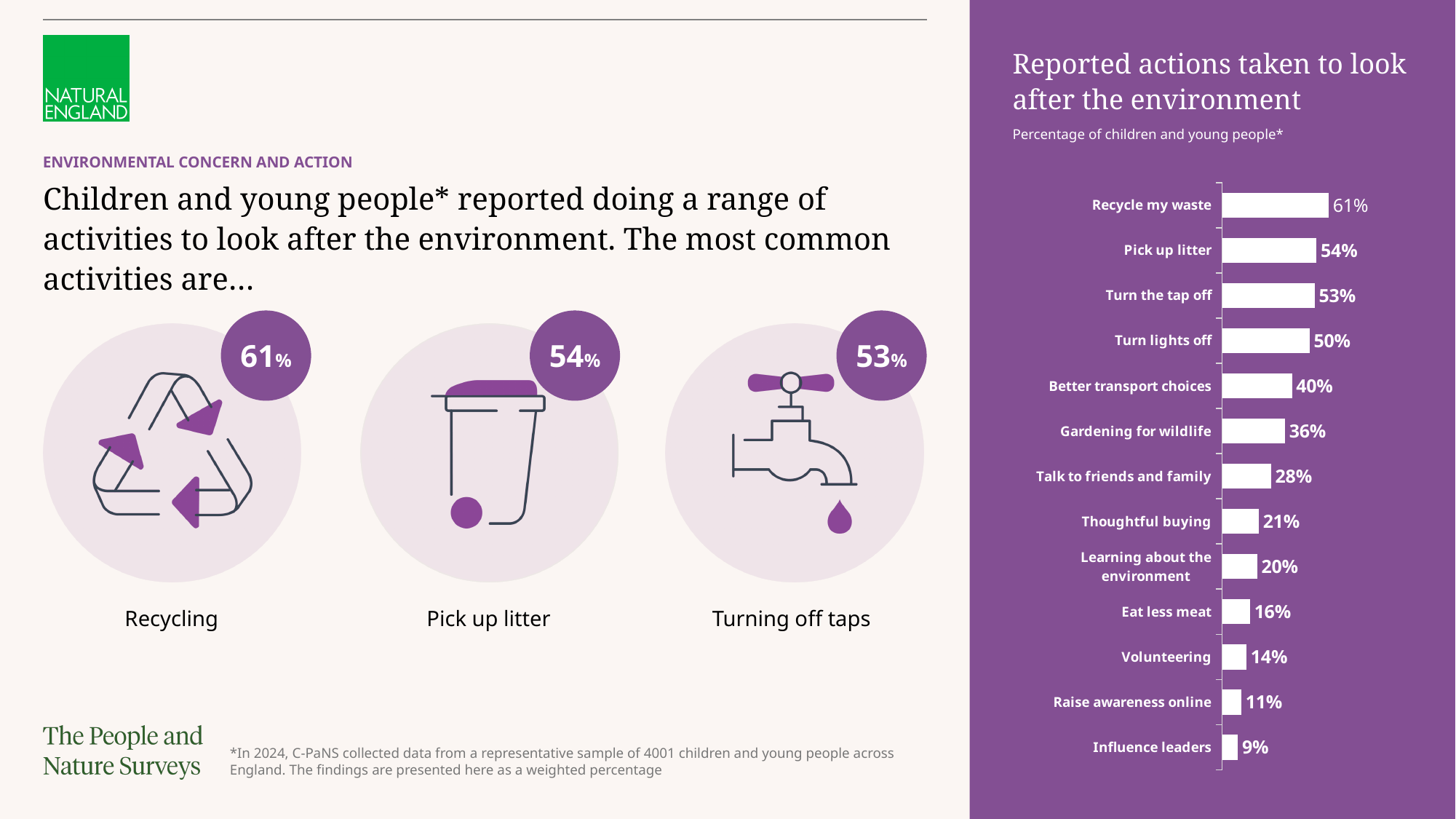
What is the value for 'Gardening for wildlife' in the bar chart? 36% What is the difference in percentage points between 'Better transport choices' and 'Eat less meat'? 24 How many reported actions are listed in the bar chart? 13 Which is larger: the value for 'Talk to friends and family' or the value for 'Thoughtful buying'? Talk to friends and family What is the title of the chart on the right side of the slide? Reported actions taken to look after the environment What is the difference in percentage points between 'Pick up litter' and 'Turn lights off'? 4 What percentage reported 'Learning about the environment'? 20% Which reported action has the lowest percentage? Influence leaders What percentage of children and young people reported that they recycle their waste? 61% Do the values rise or fall going down the list of actions from top to bottom? Fall What kind of chart is used to show the reported actions? Bar chart Which reported action has the highest percentage? Recycle my waste